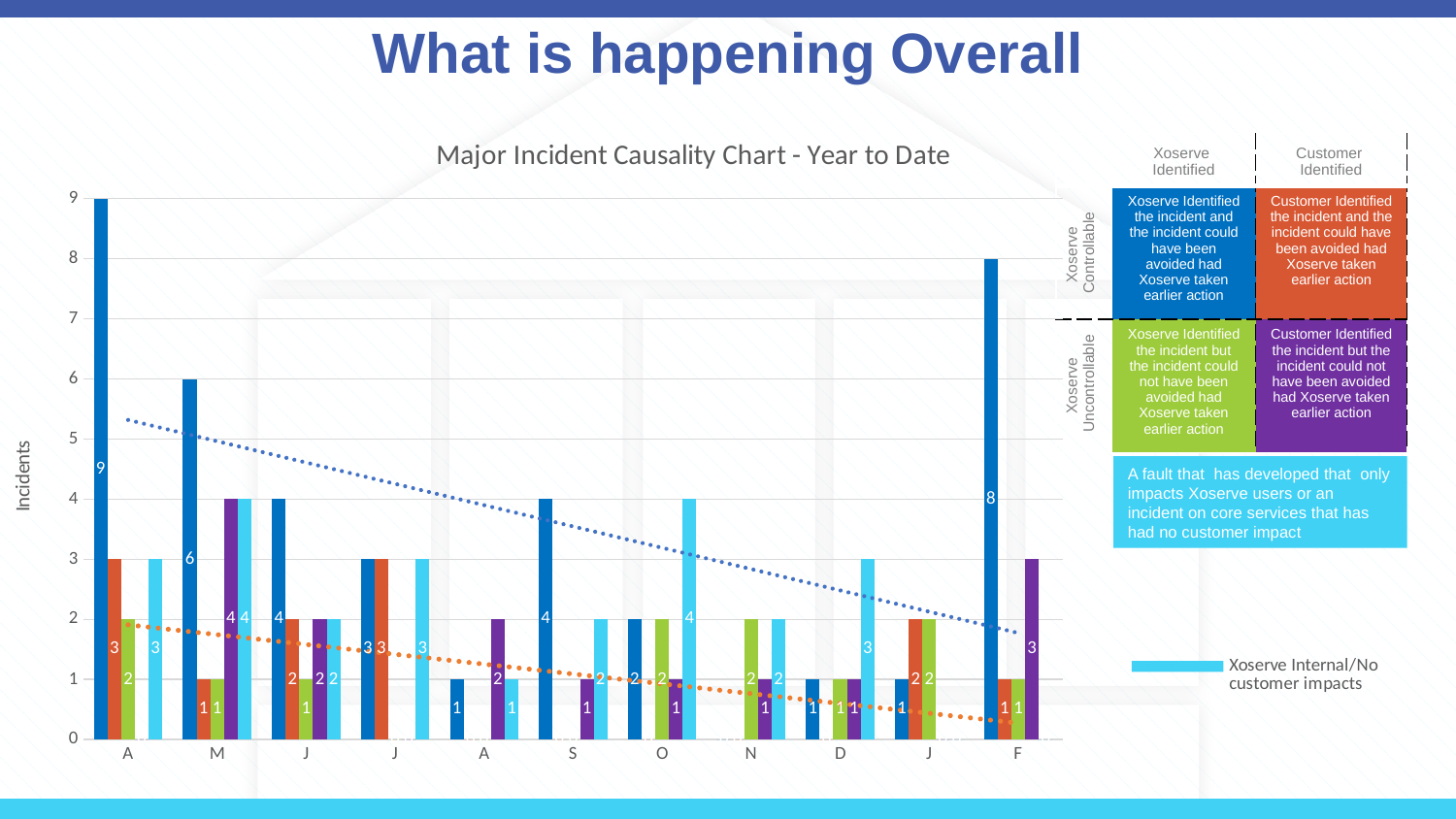
Does the blue dotted trend line rise or fall from left to right across the chart? Fall What is the value of the dark blue bar in the last month (F) of the chart? 8 What is the value of the tallest dark blue bar in the first month (A) of the chart? 9 What is the title of the chart? Major Incident Causality Chart - Year to Date In which month does the dark blue series reach its highest value? A (the first month) What type of chart is used to show the incidents by month? Bar chart How many months are shown along the x axis of the chart? 11 What is the difference between the dark blue bar in the first month (9) and the dark blue bar in the last month (8)? 1 What is the label on the y axis of the chart? Incidents What is the value of the purple bar in the month labelled M? 4 What is the value of the light blue bar in the month labelled O? 4 Which is larger: the dark blue bar in month M (6) or the dark blue bar in month S (4)? Month M (6)